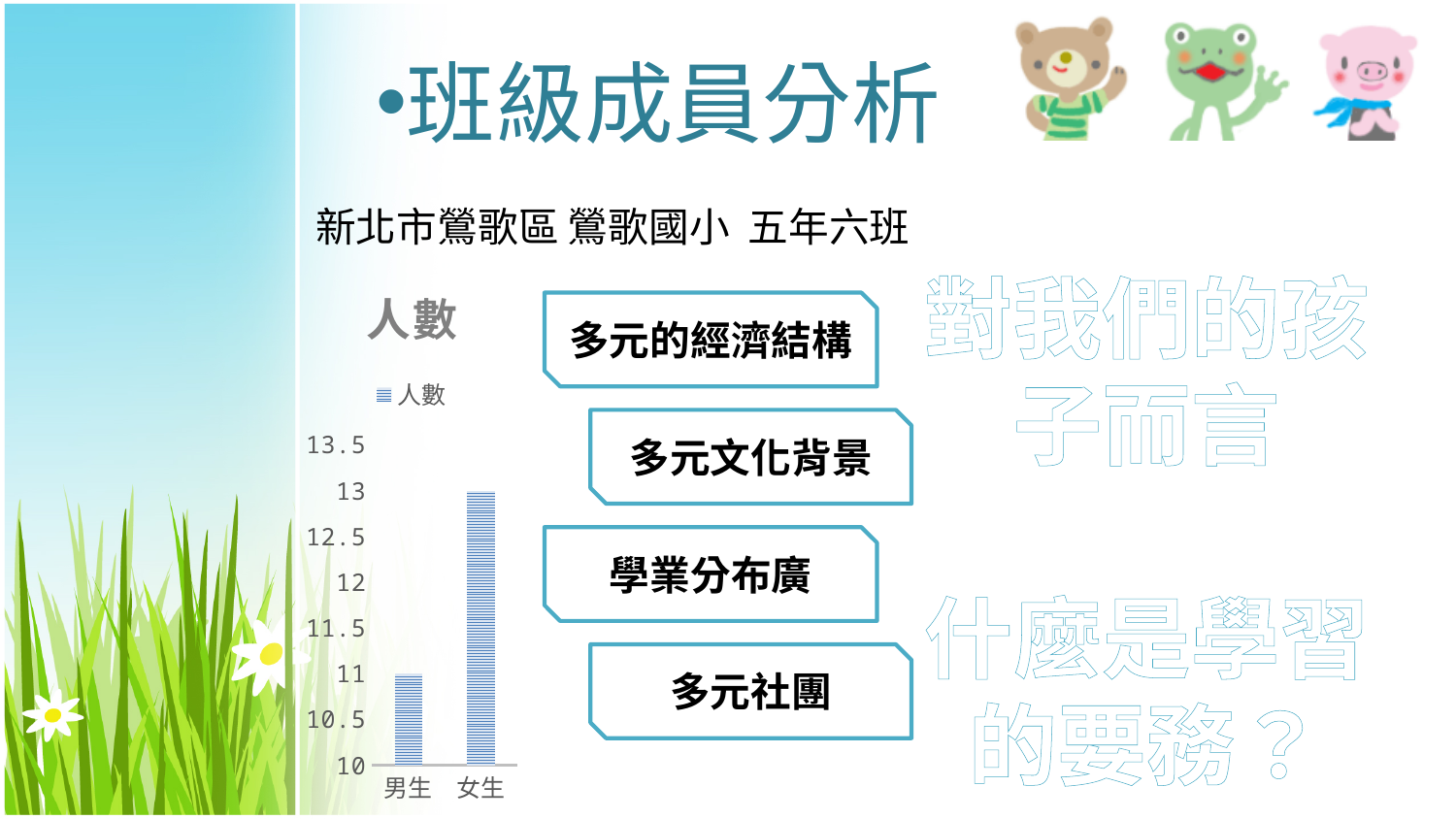
Which is larger, the value for 男生 or the value for 女生? 女生 How many series does the chart's legend list? 1 What type of chart is shown on the slide? bar chart What is the title of the chart on the slide? 人數 What is the legend entry shown in the chart? 人數 What is the difference between the values for 女生 and 男生? 2 What is the value for 女生 in the chart? 13 What is the value for 男生 in the chart? 11 How many categories are shown on the x axis of the chart? 2 Which category has the highest value in the chart? 女生 Is the value for 女生 greater or less than 12? greater Which category has the lowest value in the chart? 男生